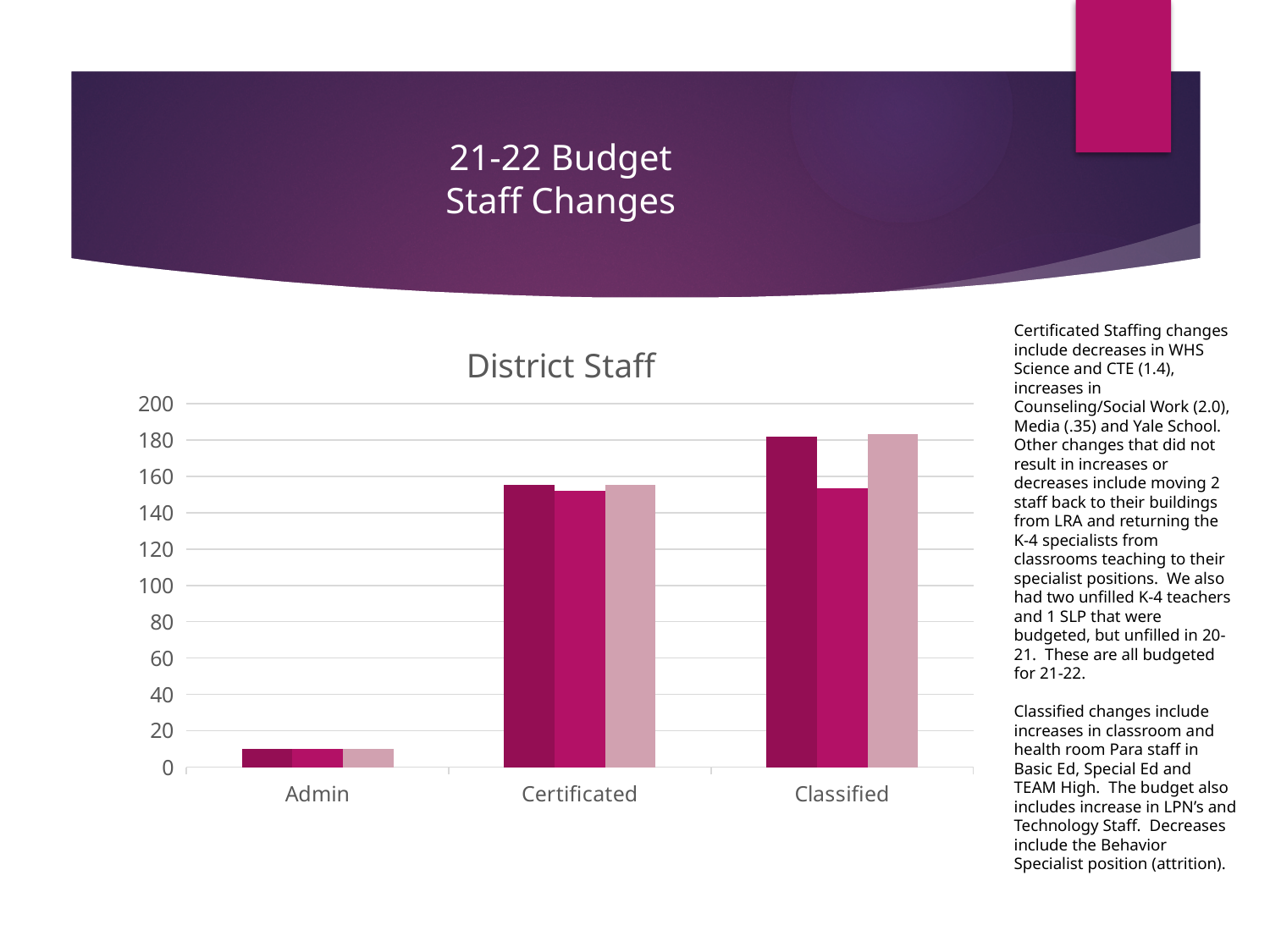
Which category has the shortest bars in the District Staff chart? Admin What kind of chart is shown on the slide? bar chart Is the value of the middle bar for Classified greater or less than 160? less Is the value of the first (leftmost) bar for Classified greater or less than 160? greater Which category has the tallest bars in the District Staff chart? Classified Are the values for Certificated greater or less than 140? greater Which category has larger values, Certificated or Admin? Certificated How many bars are plotted for each category in the District Staff chart? 3 How many categories are shown on the x axis of the District Staff chart? 3 What is the title of the chart on the slide? District Staff